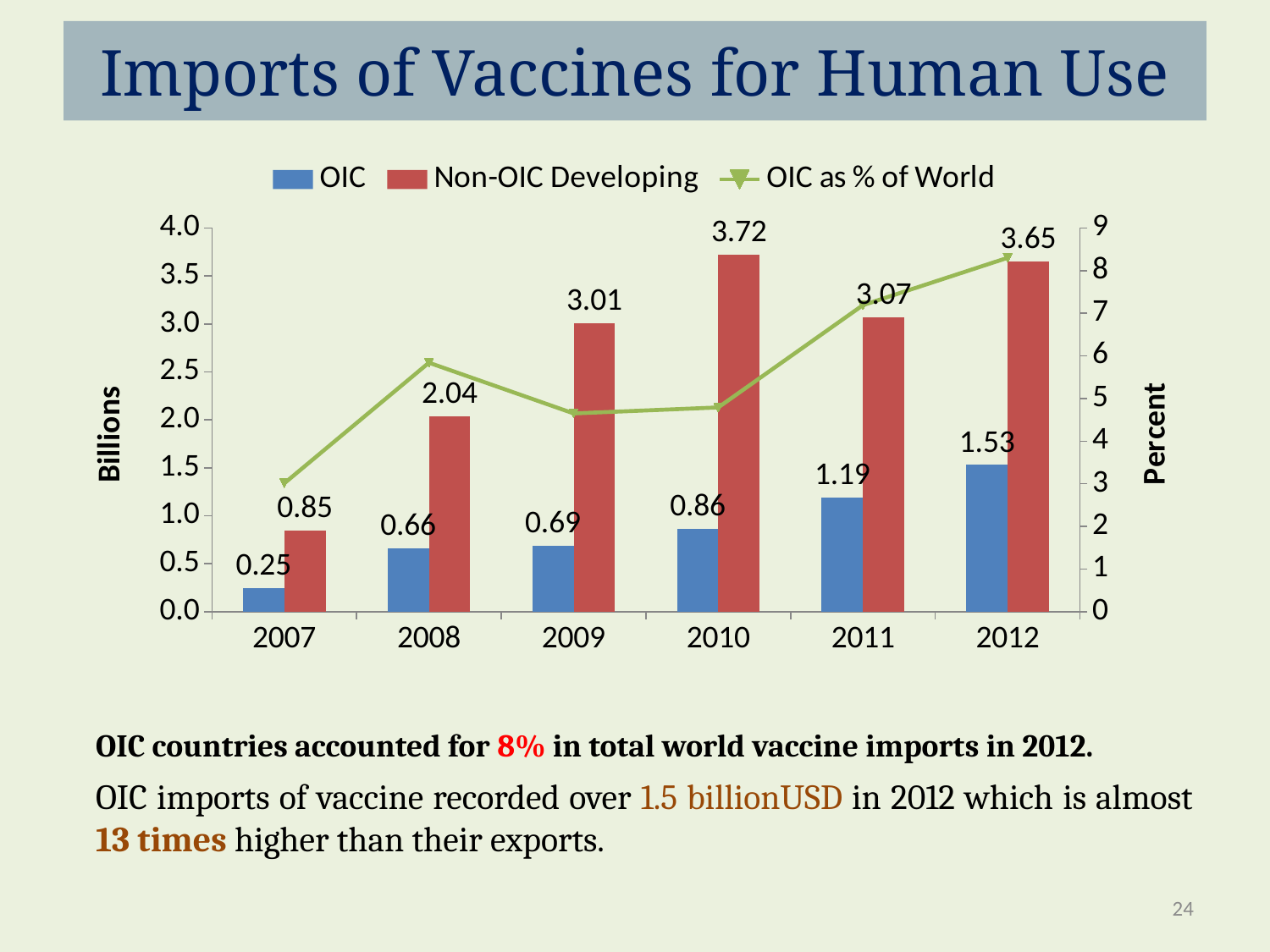
In which year is the OIC value lowest? 2007 What is the value of the OIC series for 2012? 1.53 How many series does the legend list? 3 Is the OIC as % of World value for 2012 greater or less than 7 percent? greater Which is larger in 2009: the OIC value or the Non-OIC Developing value? Non-OIC Developing How many years are shown on the x axis? 6 Is the OIC as % of World value for 2007 greater or less than 4 percent? less In which year is the Non-OIC Developing value highest? 2010 What is the difference between the Non-OIC Developing and OIC values in 2011? 1.88 What is the value of the OIC series for 2007? 0.25 What is the value of the Non-OIC Developing series for 2010? 3.72 Do the OIC values rise or fall from 2007 to 2012? rise